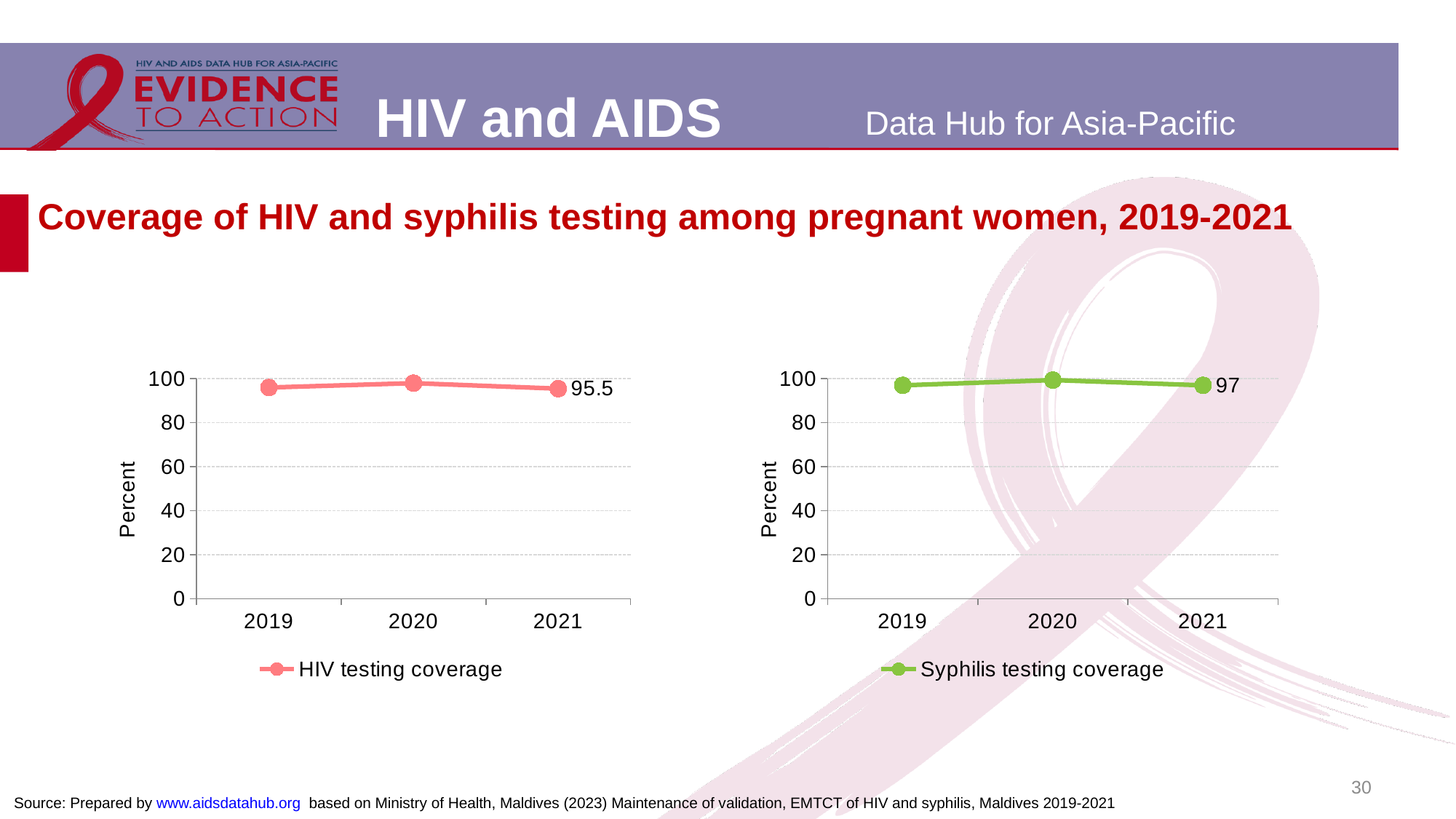
What is the difference between the 2021 syphilis testing coverage (right chart) and the 2021 HIV testing coverage (left chart)? 1.5 What is the y-axis label on the right chart? Percent What type of chart is the left chart showing HIV testing coverage? Line chart How many years are plotted on the x axis of the right chart showing syphilis testing coverage? 3 On the right chart, is the syphilis testing coverage value for 2020 greater or less than 80? greater On the left chart, what is the HIV testing coverage value labelled for 2021? 95.5 What is the legend entry of the right chart? Syphilis testing coverage On the left chart, does the HIV testing coverage line rise or fall from 2020 to 2021? fall Comparing the 2021 labelled values, which is larger: HIV testing coverage on the left chart or syphilis testing coverage on the right chart? Syphilis testing coverage On the right chart, what is the syphilis testing coverage value labelled for 2021? 97 How many series does the legend of the left chart list? 1 On the left chart, is the HIV testing coverage value for 2019 greater or less than 80? greater